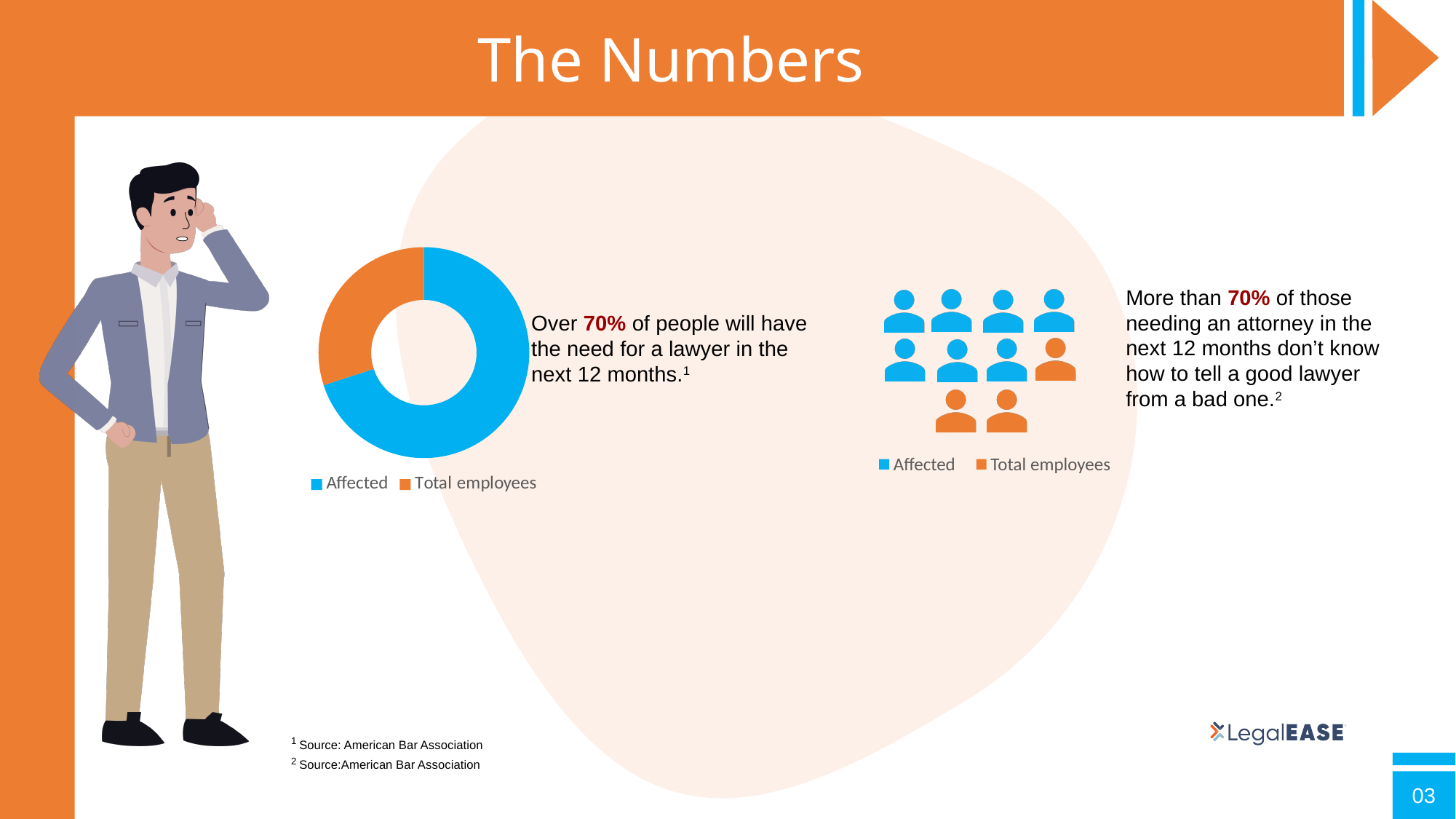
How many segments does the donut chart on the left have? 2 In the pictogram of people icons on the right, how many icons are blue (Affected)? 7 How many entries does the legend of the donut chart on the left list? 2 In the pictogram of people icons on the right, how many icons are orange (Total employees)? 3 In the donut chart on the left, which category has the smallest segment? Total employees In the pictogram of people icons on the right, how many icons are shown in total? 10 In the donut chart on the left, what colour represents Total employees? Orange In the pictogram of people icons on the right, which category has more icons, Affected or Total employees? Affected In the donut chart on the left, which category has the largest segment? Affected In the donut chart on the left, what colour represents Affected? Blue In the donut chart on the left, which segment is larger, Affected or Total employees? Affected What kind of chart is shown on the left of the slide, next to the text about needing a lawyer? Donut chart